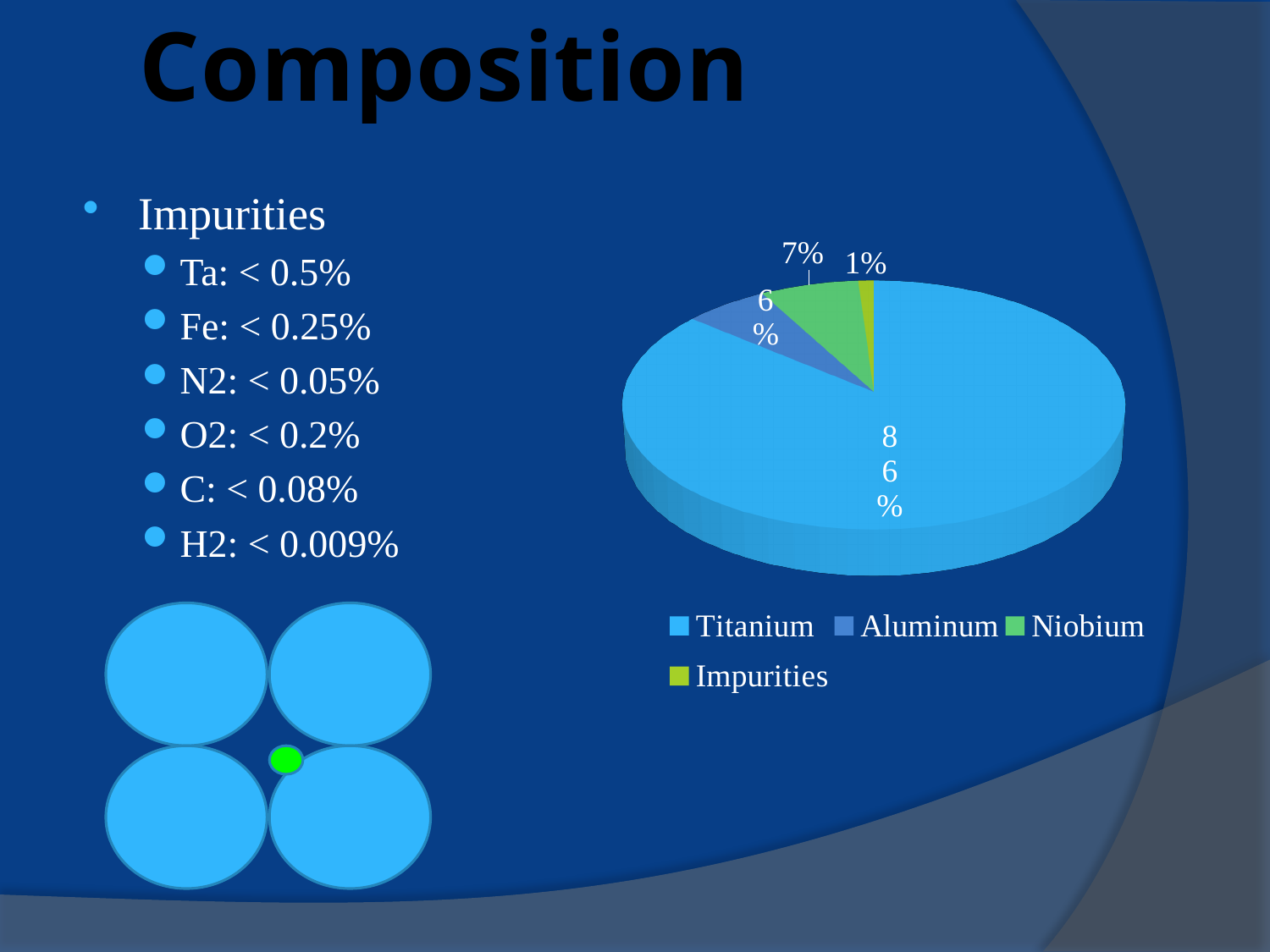
What kind of chart is shown on the slide? pie chart What is the difference between the Titanium share and the Niobium share? 79% What share of the pie does Impurities have? 1% Which slice of the pie is the largest? Titanium What is the difference between the Niobium share and the Aluminum share? 1% What share of the pie does Titanium have? 86% Which is larger, the Niobium slice or the Impurities slice? Niobium What share of the pie does Aluminum have? 6% What share of the pie does Niobium have? 7% Which legend entry is shown in green? Niobium Which slice of the pie is the smallest? Impurities How many slices does the pie chart have? 4